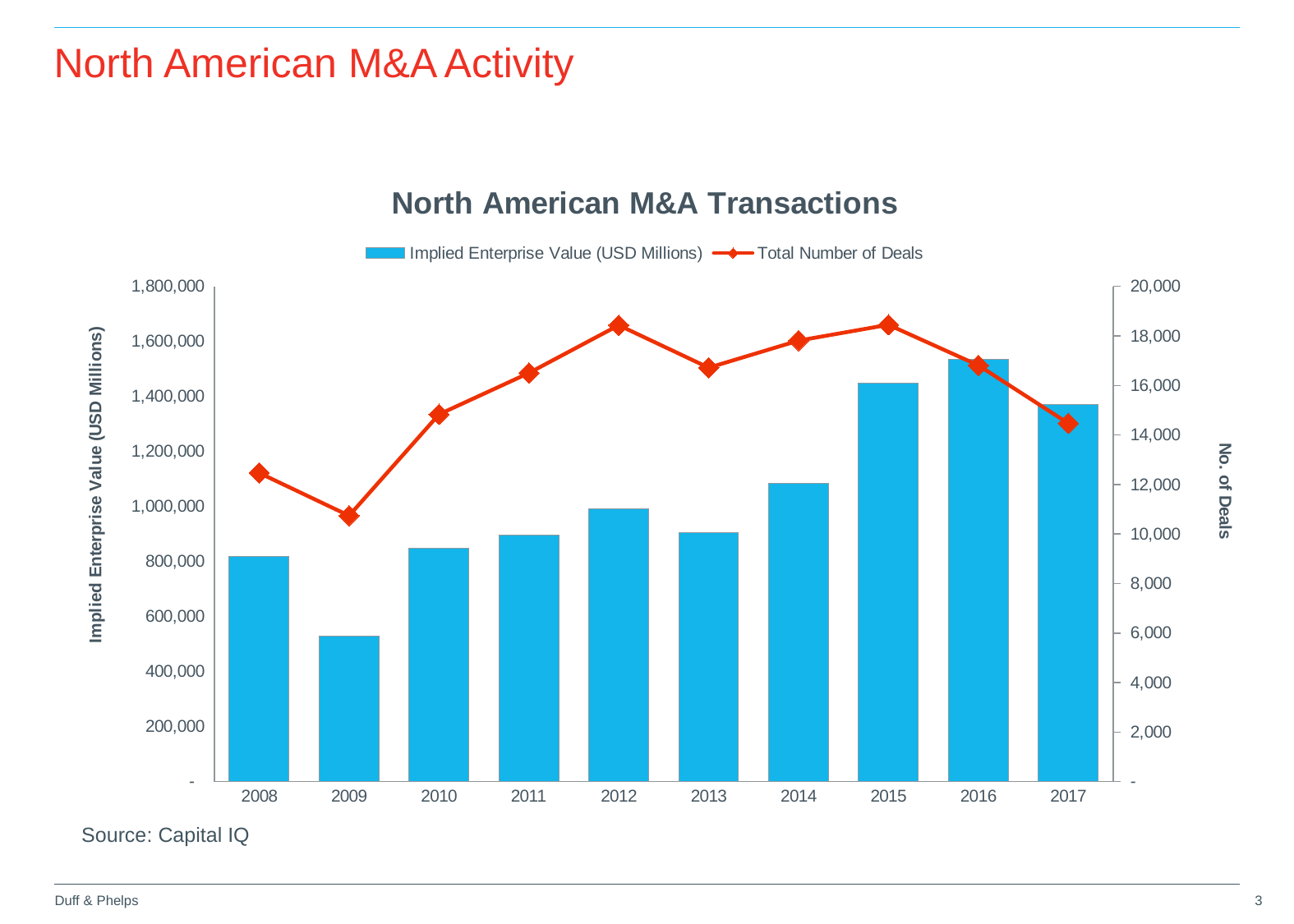
How many years are shown on the x axis? 10 Is the Implied Enterprise Value for 2009 greater or less than 600,000? less Is the Implied Enterprise Value for 2016 greater or less than 1,400,000? greater How many series does the legend list? 2 Which year has the lowest Implied Enterprise Value bar? 2009 Which year has the highest Implied Enterprise Value bar? 2016 What kind of chart is this? Combined bar and line chart Which year has the lowest Total Number of Deals? 2009 Is the Total Number of Deals for 2012 greater or less than 18,000? greater Do the Implied Enterprise Value bars rise or fall from 2009 to 2016? rise What is the title of the chart? North American M&A Transactions Which year has the larger Implied Enterprise Value, 2014 or 2015? 2015